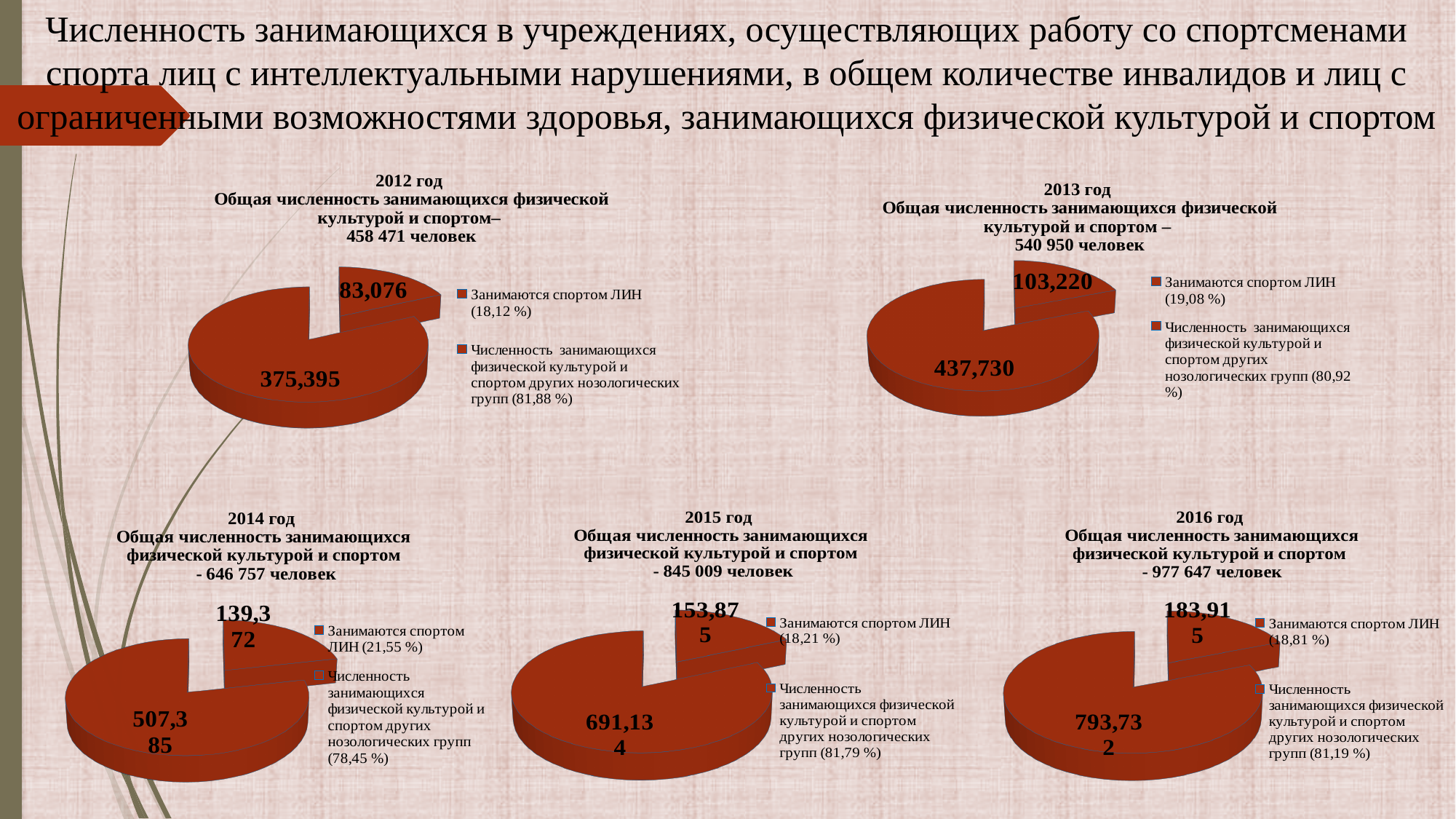
In the 2015 pie chart, which slice is larger: 'Занимаются спортом ЛИН' or 'Численность занимающихся физической культурой и спортом других нозологических групп'? Численность занимающихся физической культурой и спортом других нозологических групп How many slices does the 2014 pie chart have? 2 How many pie charts are shown on the slide? 5 In the 2015 pie chart, what is the value for the larger slice? 691,134 In the 2012 pie chart, what is the value for the slice 'Занимаются спортом ЛИН'? 83,076 In the 2016 pie chart, what is the value for the slice 'Занимаются спортом ЛИН'? 183,915 What type of chart is used for the 2013 data? Pie chart In the 2014 pie chart, what share of the pie does the slice 'Занимаются спортом ЛИН' represent, according to the legend? 21,55 % In the 2013 pie chart, what is the difference between the two slice values? 334,510 In the 2012 pie chart, what is the difference between the two slice values? 292,319 In the 2016 pie chart, what share of the pie does the slice 'Численность занимающихся физической культурой и спортом других нозологических групп' represent, according to the legend? 81,19 % In the 2013 pie chart, what is the value for the slice 'Численность занимающихся физической культурой и спортом других нозологических групп'? 437,730